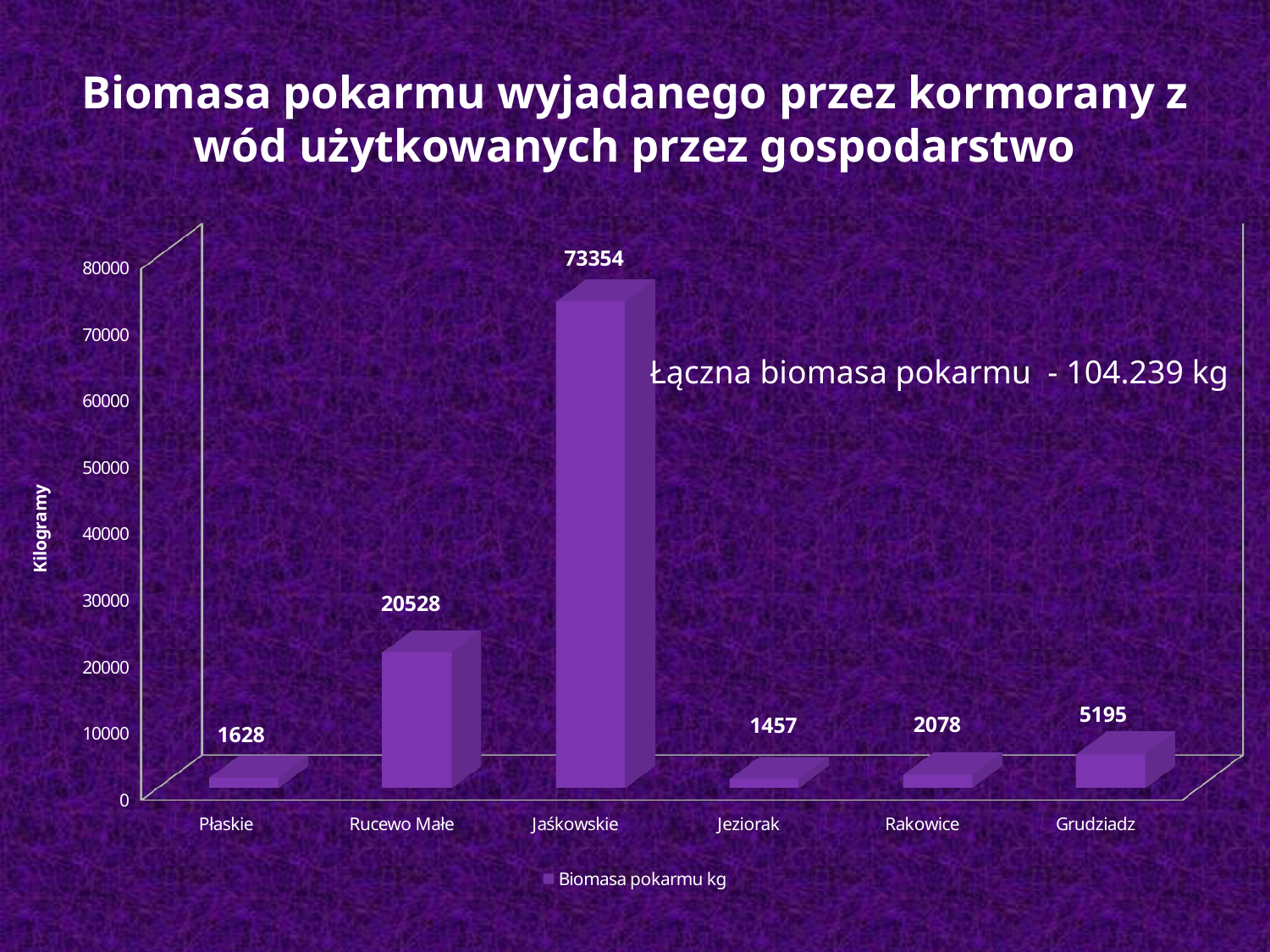
What is the value for Grudziadz? 5195 What is the value for Jaśkowskie? 73354 Which category has the highest value? Jaśkowskie What kind of chart is shown on the slide? bar chart How many categories are shown on the x axis? 6 Which is larger, the value for Płaskie or the value for Grudziadz? Grudziadz What is the value for Rucewo Małe? 20528 Which category has the lowest value? Jeziorak What is the difference between the values for Jaśkowskie and Rucewo Małe? 52826 Is the value for Rucewo Małe greater or less than 30000? less What is the legend entry for the series? Biomasa pokarmu kg What is the difference between the values for Rakowice and Jeziorak? 621